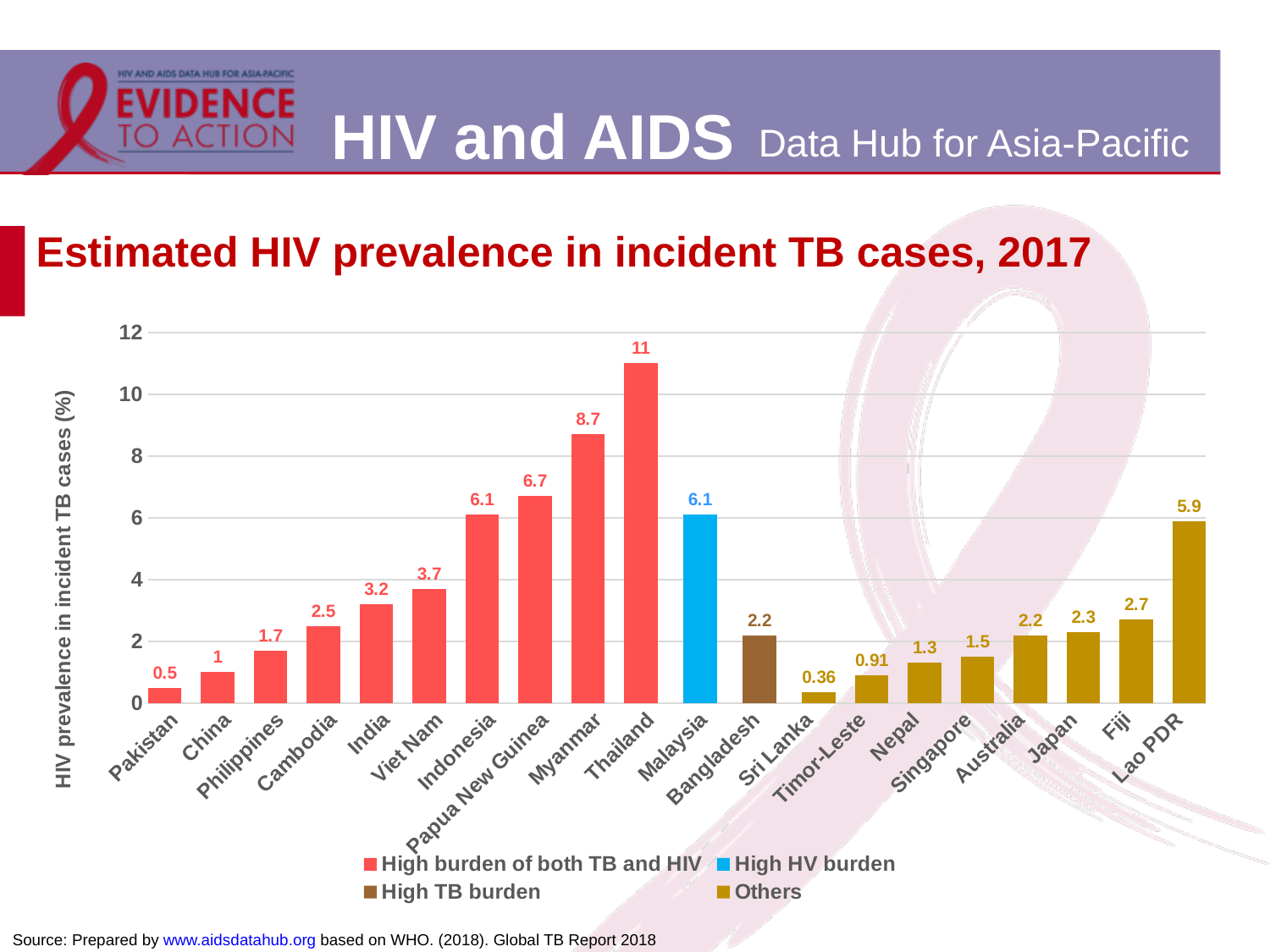
What is the value shown for Sri Lanka? 0.36 What is the value shown for Lao PDR? 5.9 Which legend category does Malaysia belong to? High HV burden Which country has the lowest HIV prevalence in incident TB cases? Sri Lanka How many countries are shown on the x axis? 20 What is the difference between the values for Myanmar and Papua New Guinea? 2 What kind of chart is shown on the slide? Bar chart Which has a higher value, Fiji or Japan? Fiji How many series does the legend list? 4 Is the value for Lao PDR greater or less than 4? greater Which country has the highest HIV prevalence in incident TB cases? Thailand What is the estimated HIV prevalence in incident TB cases for Thailand? 11